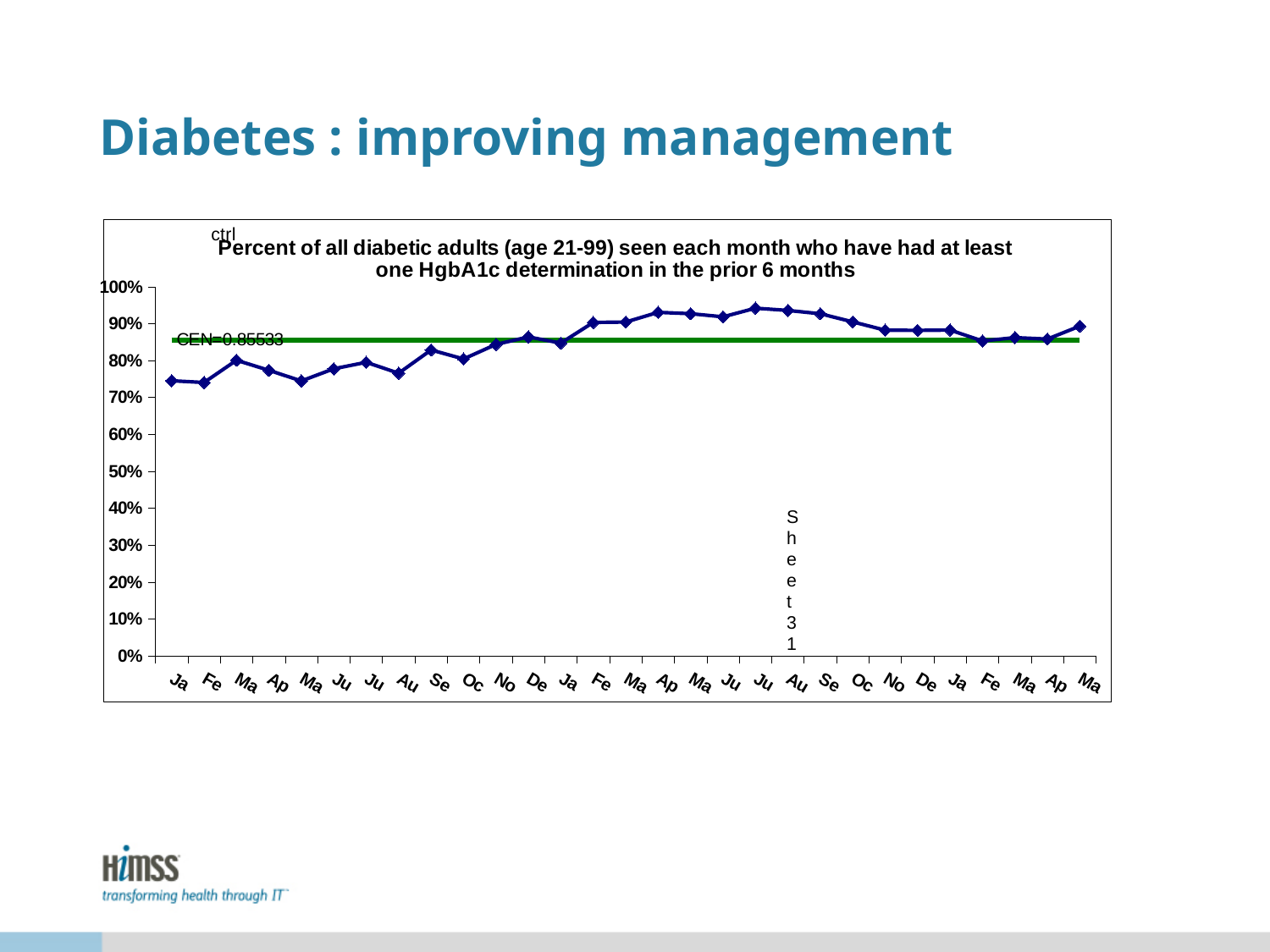
Which is larger, the value of the first point on the left or the value of the last point on the right? the last point on the right How many data points are plotted on the line? 29 What value is printed on the horizontal green center line? CEN=0.85533 What kind of chart is shown on the slide? line chart Is the first point on the line above or below the green center line? below Overall, do the values rise or fall from the left of the x axis to the right? rise What is the maximum value shown on the y axis? 100% What is the title of the chart? Percent of all diabetic adults (age 21-99) seen each month who have had at least one HgbA1c determination in the prior 6 months Is the value for the last point (Ma, far right) greater or less than 80%? greater Is the lowest point on the line greater or less than 80%? less Is the value for the first point (Ja, far left) greater or less than 80%? less